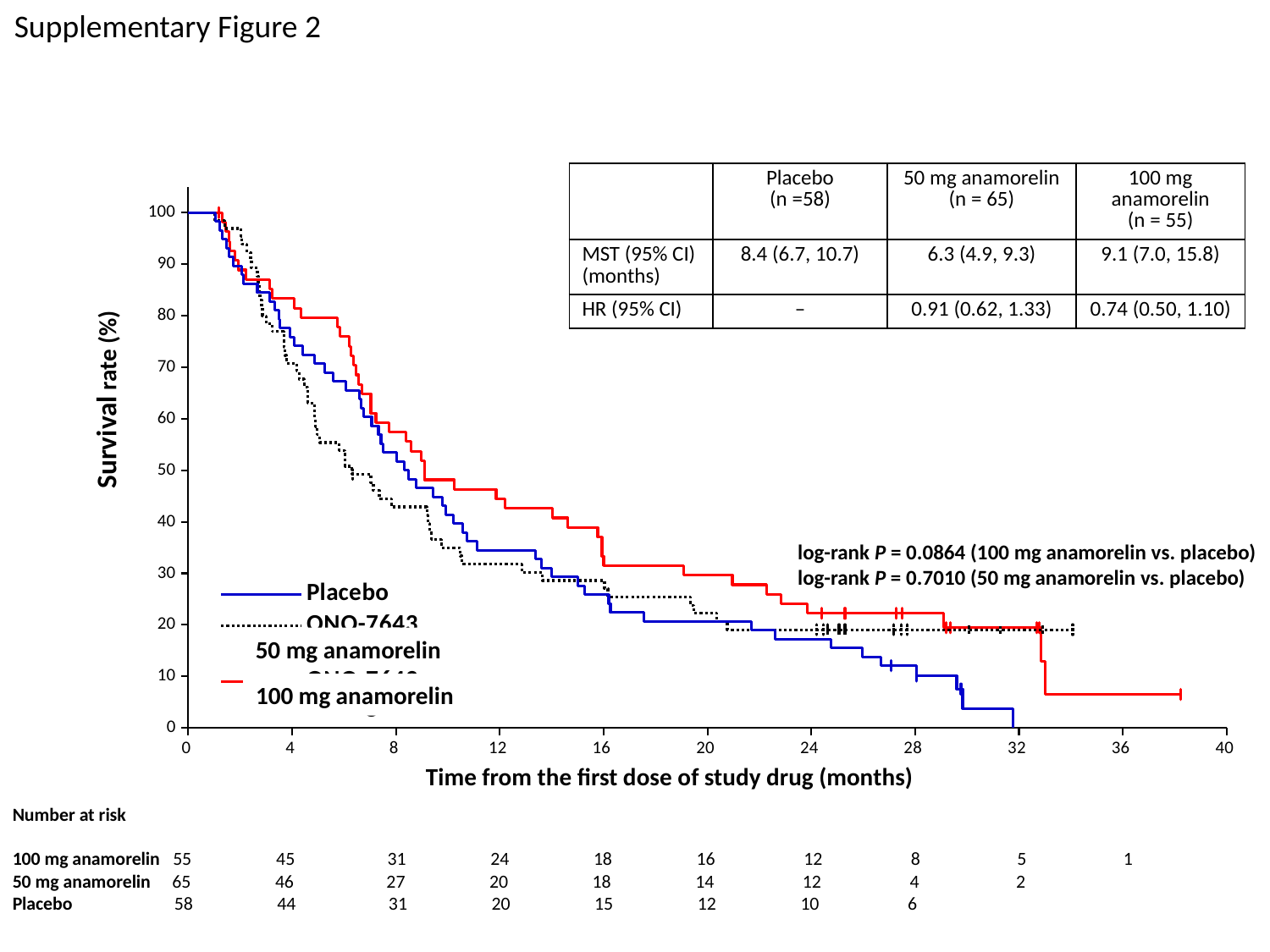
What is the log-rank P value for 100 mg anamorelin vs. placebo? 0.0864 What is the label of the x axis? Time from the first dose of study drug (months) What kind of chart is shown on the slide? line chart Which group has the lowest MST in the table? 50 mg anamorelin According to the table, what is the HR (95% CI) for 100 mg anamorelin? 0.74 (0.50, 1.10) According to the table, what is the MST (95% CI) in months for the placebo group? 8.4 (6.7, 10.7) What is the number at risk for placebo at 16 months? 15 Is the survival rate for 100 mg anamorelin at 8 months greater or less than 50? greater Which group has the highest MST in the table? 100 mg anamorelin What is the difference in MST between the 100 mg anamorelin group and the placebo group? 0.7 months Do the survival rate curves rise or fall as time from the first dose increases? fall How many series does the legend list? 3